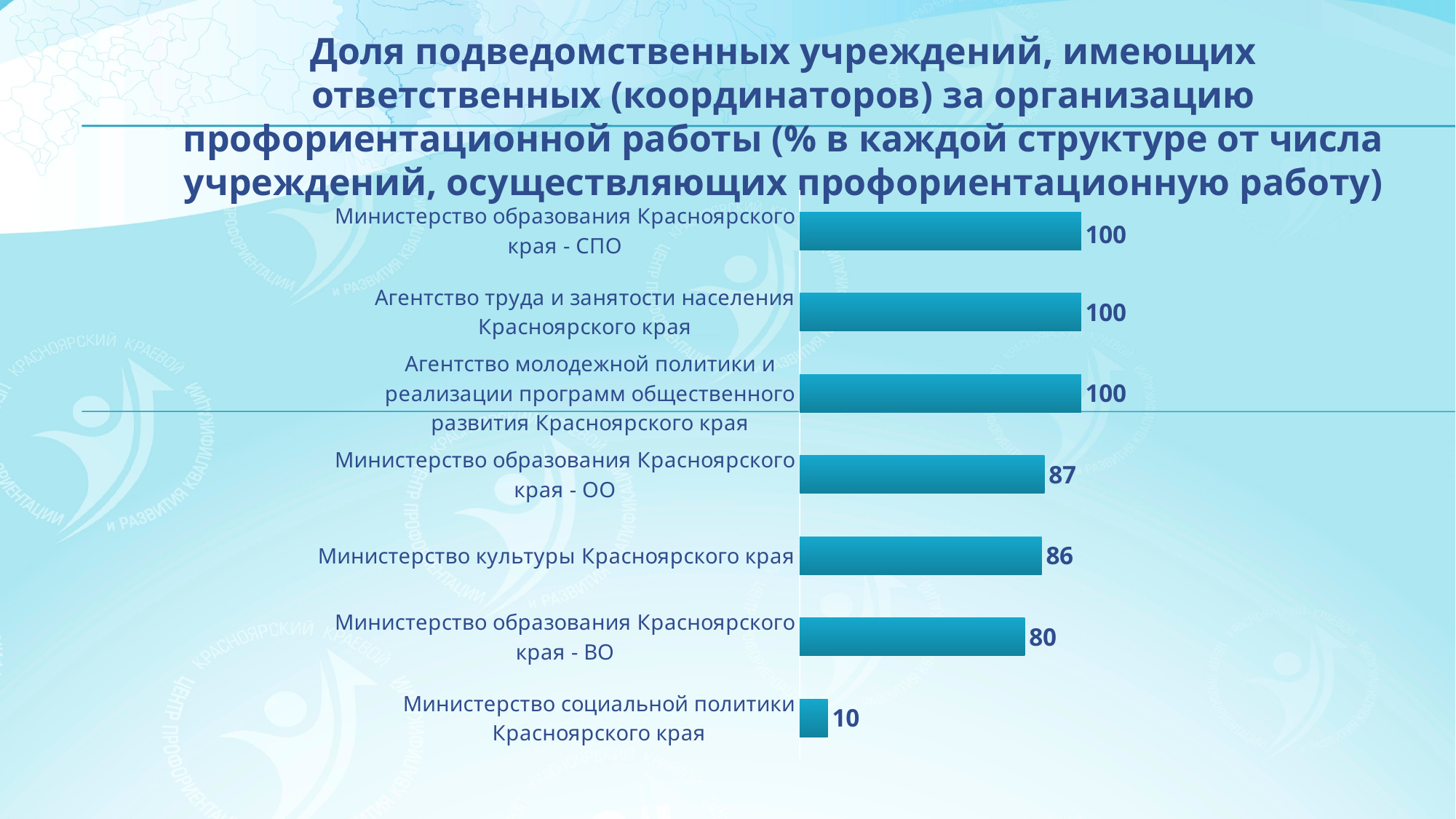
How many categories have a value of 100? 3 What is the difference between the values for Министерство образования Красноярского края - ОО and Министерство образования Красноярского края - ВО? 7 Which category has the lowest value? Министерство социальной политики Красноярского края What is the value for Министерство образования Красноярского края - ОО? 87 What is the value for Министерство социальной политики Красноярского края? 10 What is the value for Министерство образования Красноярского края - ВО? 80 Which is larger: the value for Министерство культуры Красноярского края or the value for Министерство образования Красноярского края - ВО? Министерство культуры Красноярского края How many categories are shown in the chart? 7 What kind of chart is shown on the slide? Bar chart What is the value for Агентство труда и занятости населения Красноярского края? 100 What is the difference between the values for Министерство образования Красноярского края - СПО and Министерство социальной политики Красноярского края? 90 What is the value for Министерство культуры Красноярского края? 86